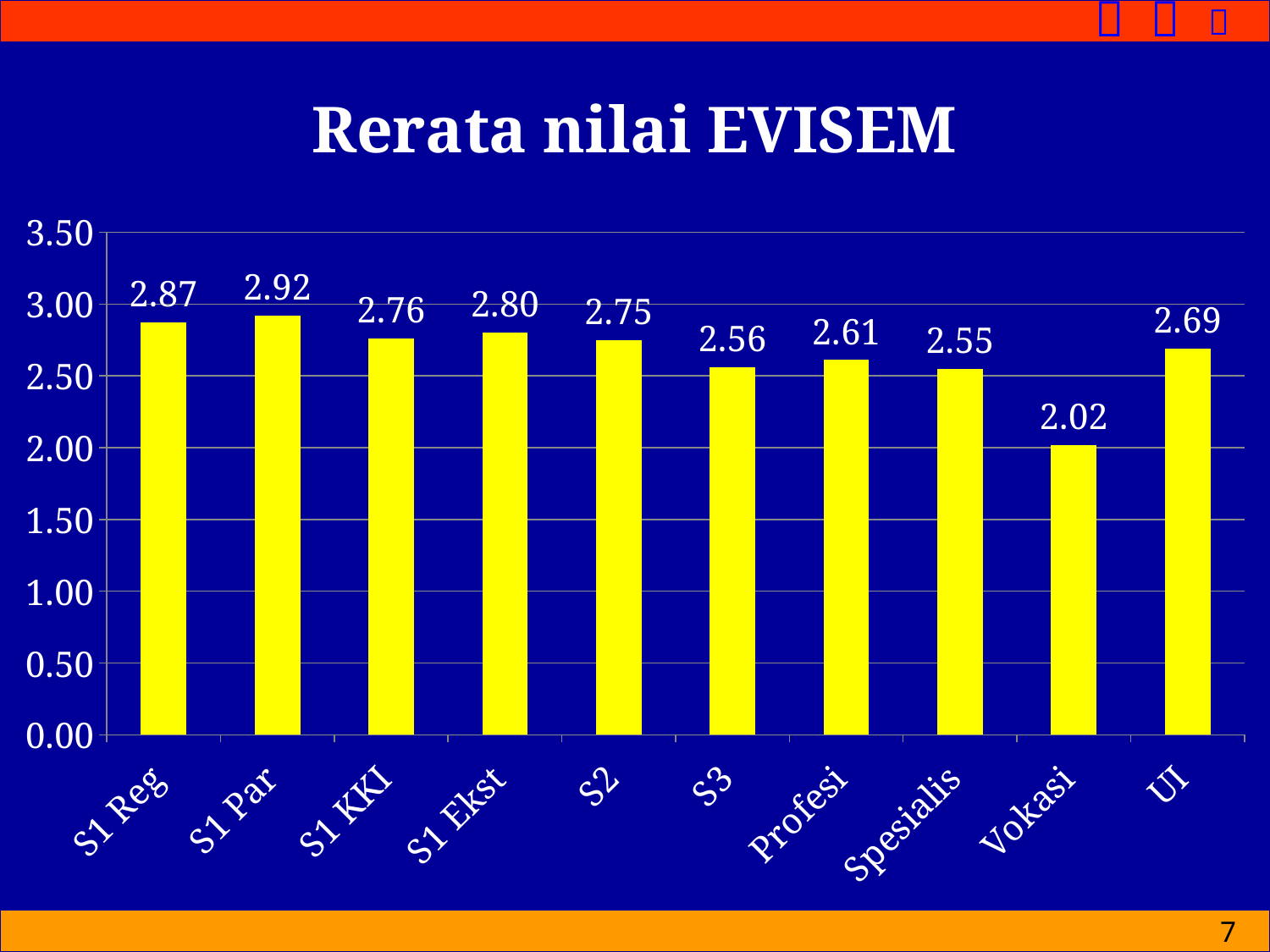
What kind of chart is shown on the slide? bar chart Is the value for Profesi greater or less than 3.00? less What colour are the bars in the chart? yellow What is the value for S1 Reg? 2.87 What is the value for UI? 2.69 What is the title of the chart? Rerata nilai EVISEM What is the value for Vokasi? 2.02 How many categories are shown on the x axis? 10 What is the difference between the values for S1 Par and Vokasi? 0.90 Which category has the lowest value? Vokasi Which category has the highest value? S1 Par Which is larger, the value for S1 Ekst or the value for S3? S1 Ekst